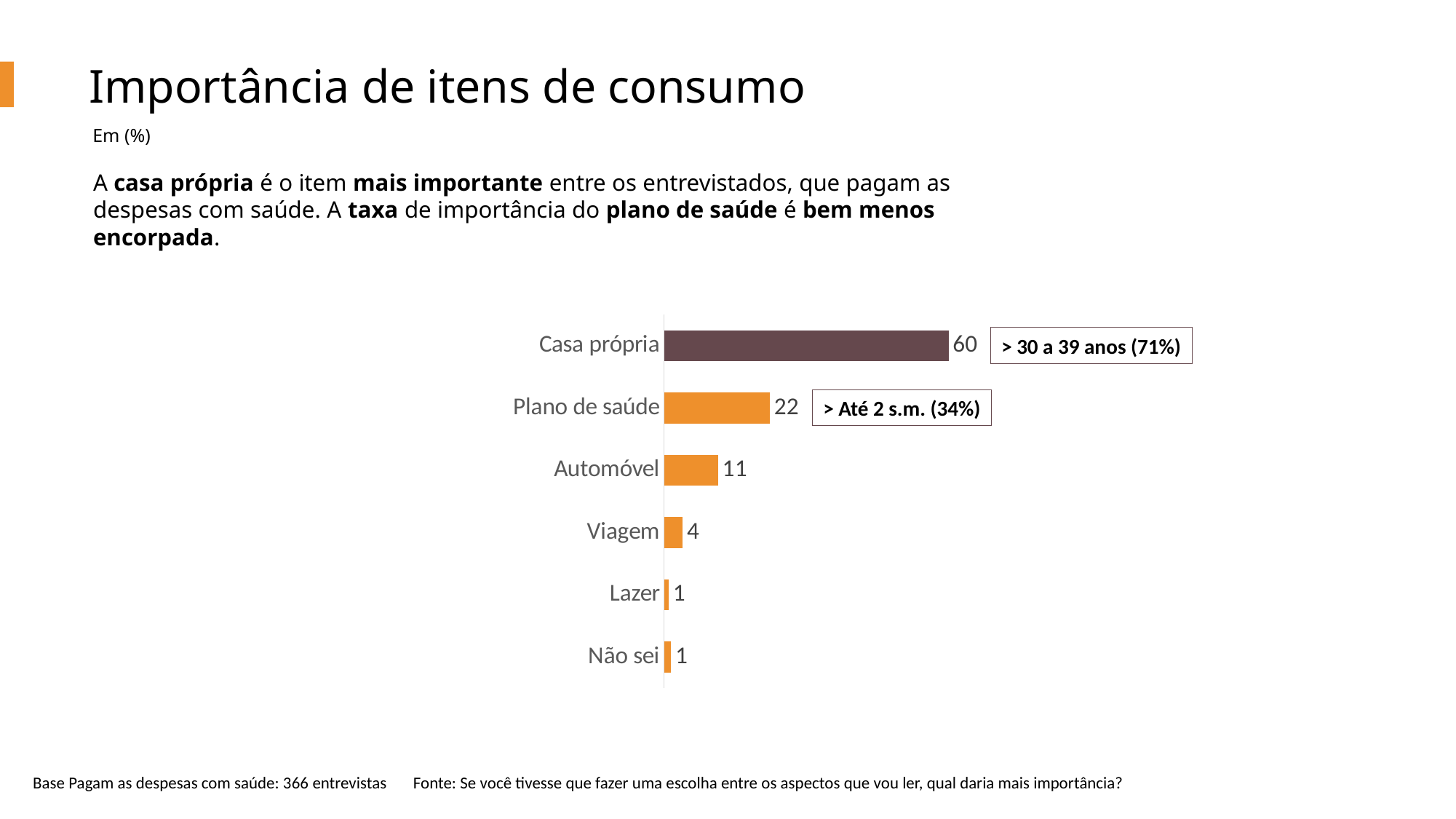
What is the difference between the values for Plano de saúde and Automóvel? 11 What kind of chart is shown on the slide? Bar chart Which category's bar is shown in a different colour from the others? Casa própria What is the value for Casa própria? 60 Which is larger, the value for Automóvel or the value for Viagem? Automóvel What is the value for Viagem? 4 Which category has the highest value? Casa própria What is the difference between the values for Casa própria and Plano de saúde? 38 What is the value for Automóvel? 11 How many categories are shown in the chart? 6 What is the value for Lazer? 1 What is the value for Plano de saúde? 22